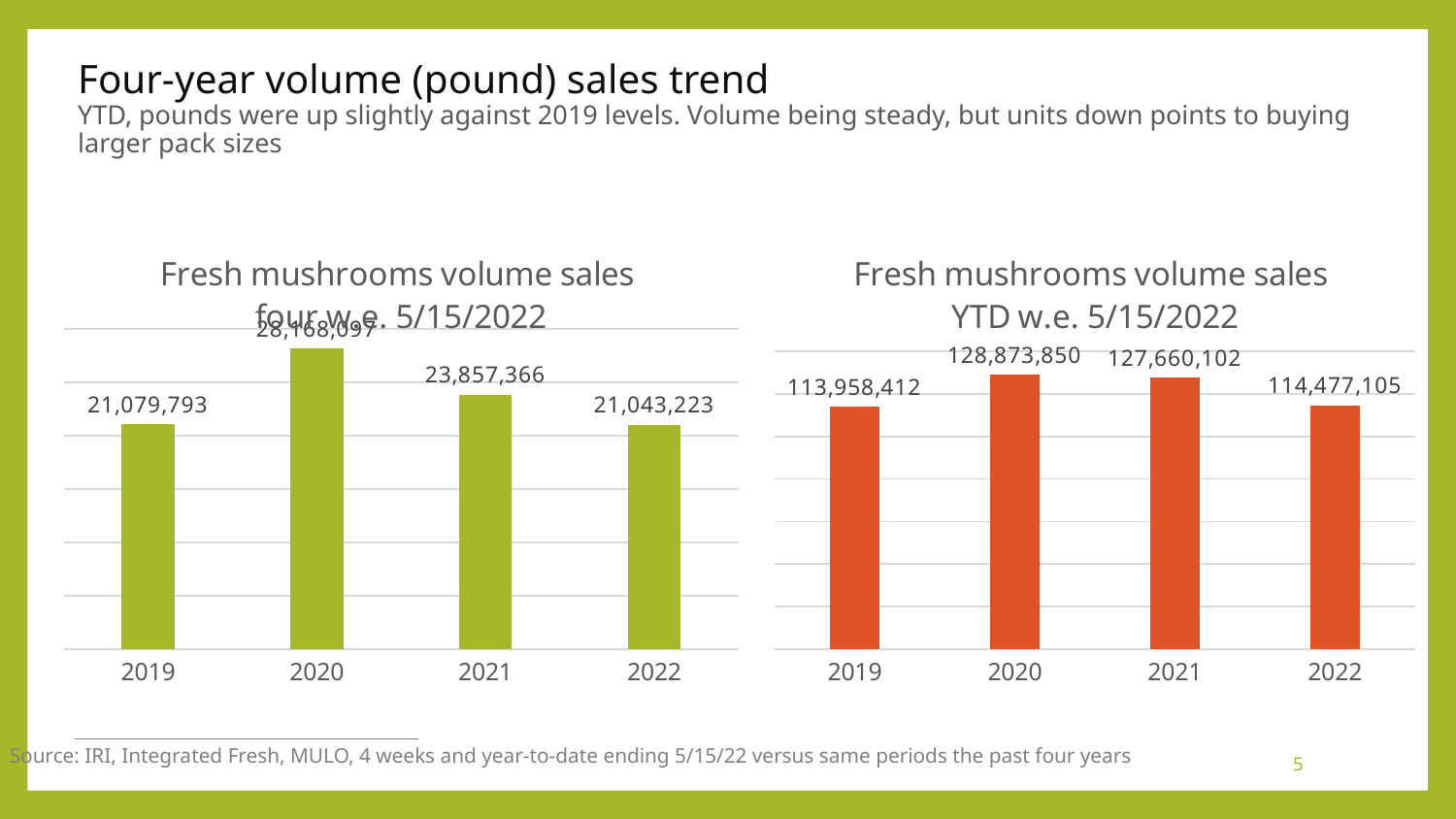
In the right chart (YTD w.e. 5/15/2022), what is the difference between the 2020 and 2021 values? 1,213,748 In the left chart (four w.e. 5/15/2022), what is the difference between the 2021 and 2022 values? 2,814,143 In the left chart (four w.e. 5/15/2022), which year has the highest volume sales? 2020 In the left chart (four w.e. 5/15/2022), what is the volume sales value for 2021? 23,857,366 How many years are shown on the x axis of the right chart (YTD w.e. 5/15/2022)? 4 In the right chart (YTD w.e. 5/15/2022), which is larger, the value for 2019 or the value for 2022? 2022 In the right chart (YTD w.e. 5/15/2022), which year has the lowest volume sales? 2019 In the left chart (four w.e. 5/15/2022), what is the volume sales value for 2019? 21,079,793 In the left chart (four w.e. 5/15/2022), what is the volume sales value for 2022? 21,043,223 In the right chart (YTD w.e. 5/15/2022), what is the volume sales value for 2020? 128,873,850 What type of chart is the left chart (four w.e. 5/15/2022)? Bar chart In the right chart (YTD w.e. 5/15/2022), what is the volume sales value for 2022? 114,477,105